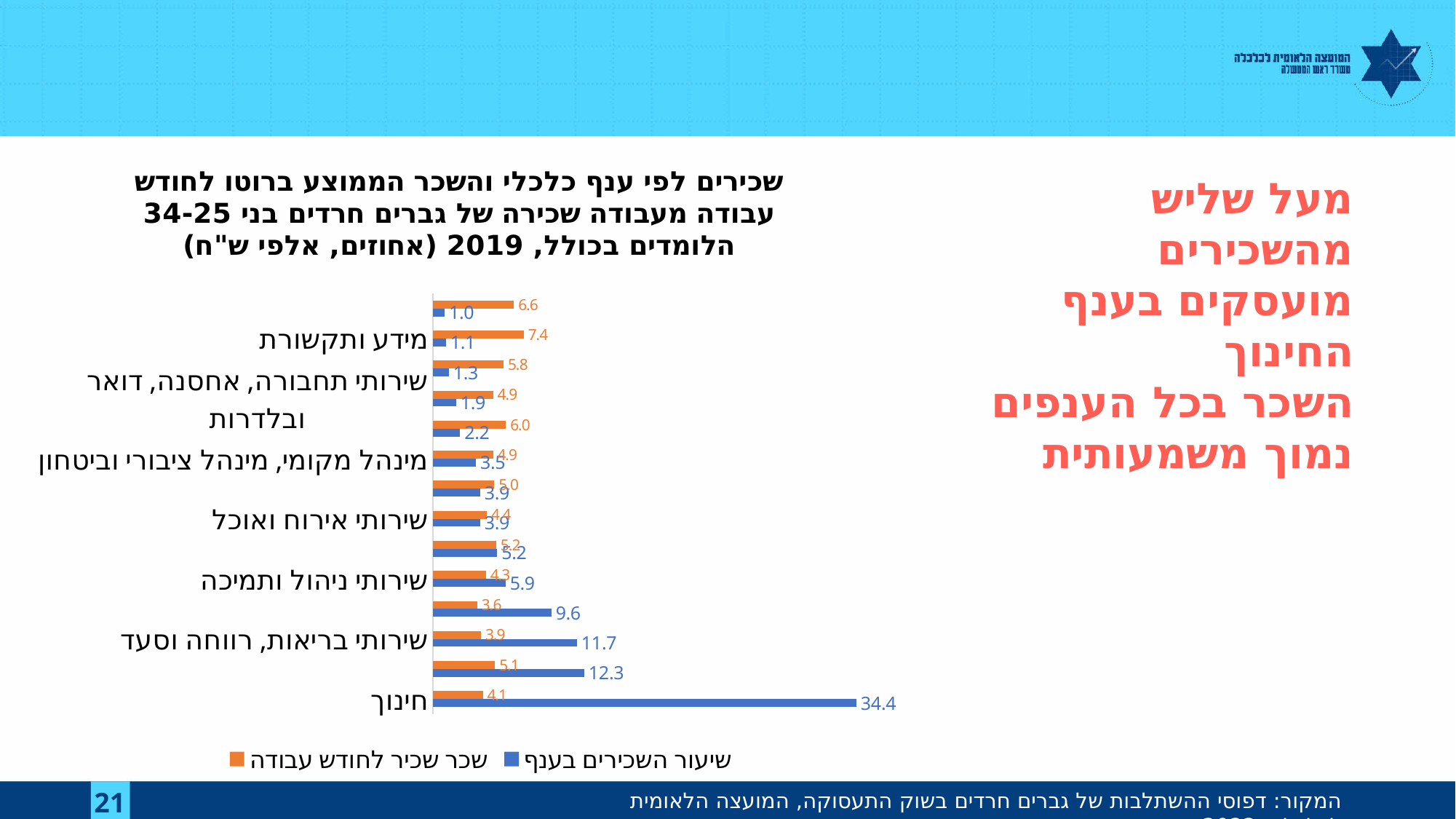
What is the value of שכר שכיר לחודש עבודה for מידע ותקשורת? 7.4 What is the difference in שיעור השכירים בענף between חינוך and שירותי בריאות, רווחה וסעד? 22.7 What is the value of שכר שכיר לחודש עבודה for חינוך? 4.1 Which labelled category has the highest value of שיעור השכירים בענף? חינוך Which is larger for מידע ותקשורת: שיעור השכירים בענף or שכר שכיר לחודש עבודה? שכר שכיר לחודש עבודה How many series does the legend list? 2 Which colour represents the series שכר שכיר לחודש עבודה in the legend? orange What is the value of שיעור השכירים בענף for שירותי בריאות, רווחה וסעד? 11.7 Which is larger: שיעור השכירים בענף for חינוך or for שירותי ניהול ותמיכה? חינוך What is the value of שיעור השכירים בענף for חינוך? 34.4 What is the value of שיעור השכירים בענף for מידע ותקשורת? 1.1 What type of chart is shown on the slide? bar chart